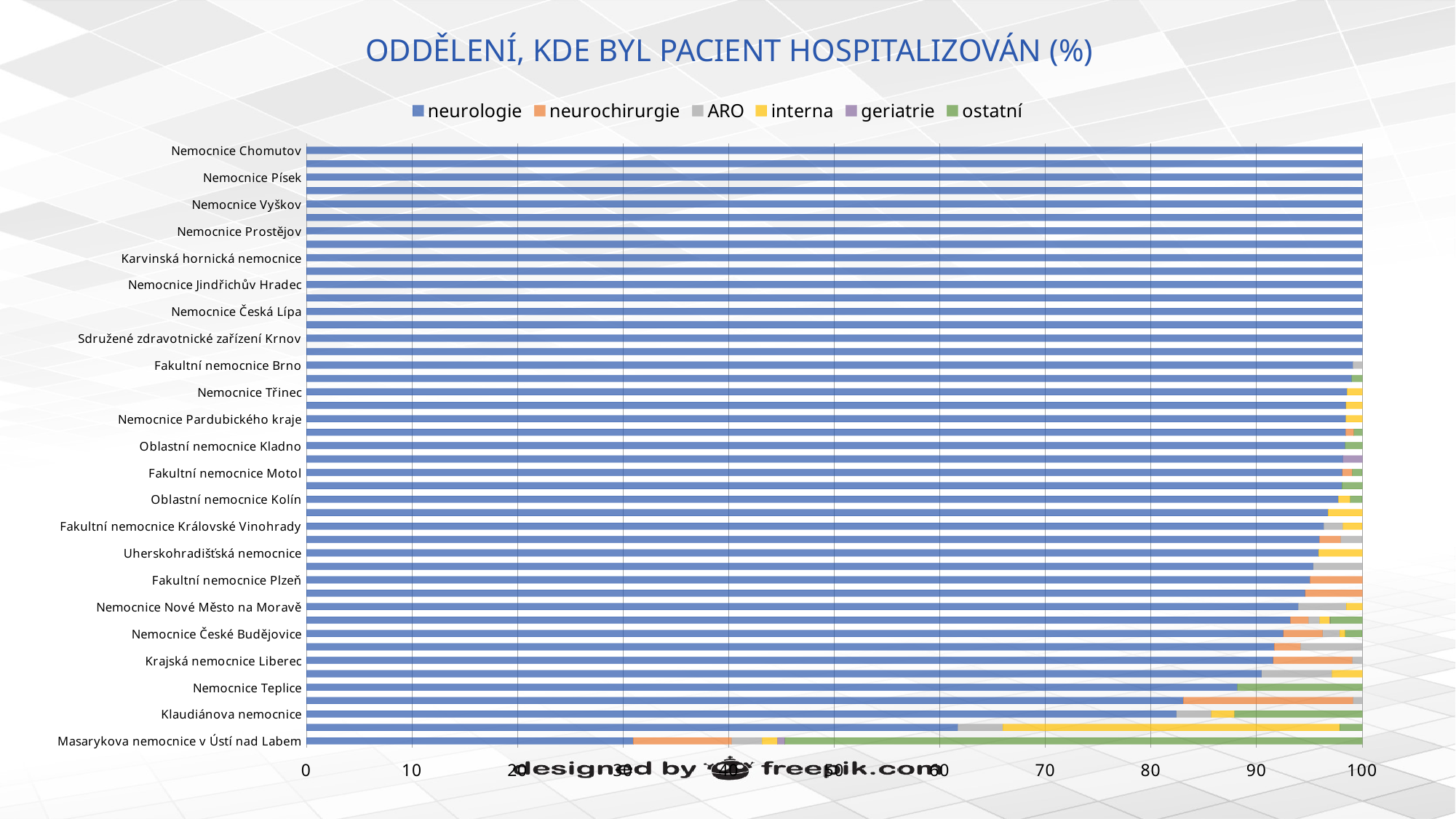
What is the title of the chart? ODDĚLENÍ, KDE BYL PACIENT HOSPITALIZOVÁN (%) Is the neurologie value for Nemocnice Teplice greater or less than 80? greater What kind of chart is shown on the slide? bar chart Which has a larger neurologie share, Klaudiánova nemocnice or Masarykova nemocnice v Ústí nad Labem? Klaudiánova nemocnice Is the neurologie value for Masarykova nemocnice v Ústí nad Labem greater or less than 40? less Which hospital has the lowest neurologie share? Masarykova nemocnice v Ústí nad Labem Is the neurologie value for Nemocnice Chomutov greater or less than 90? greater How many series does the legend list? 6 Which series is shown in blue in the legend? neurologie